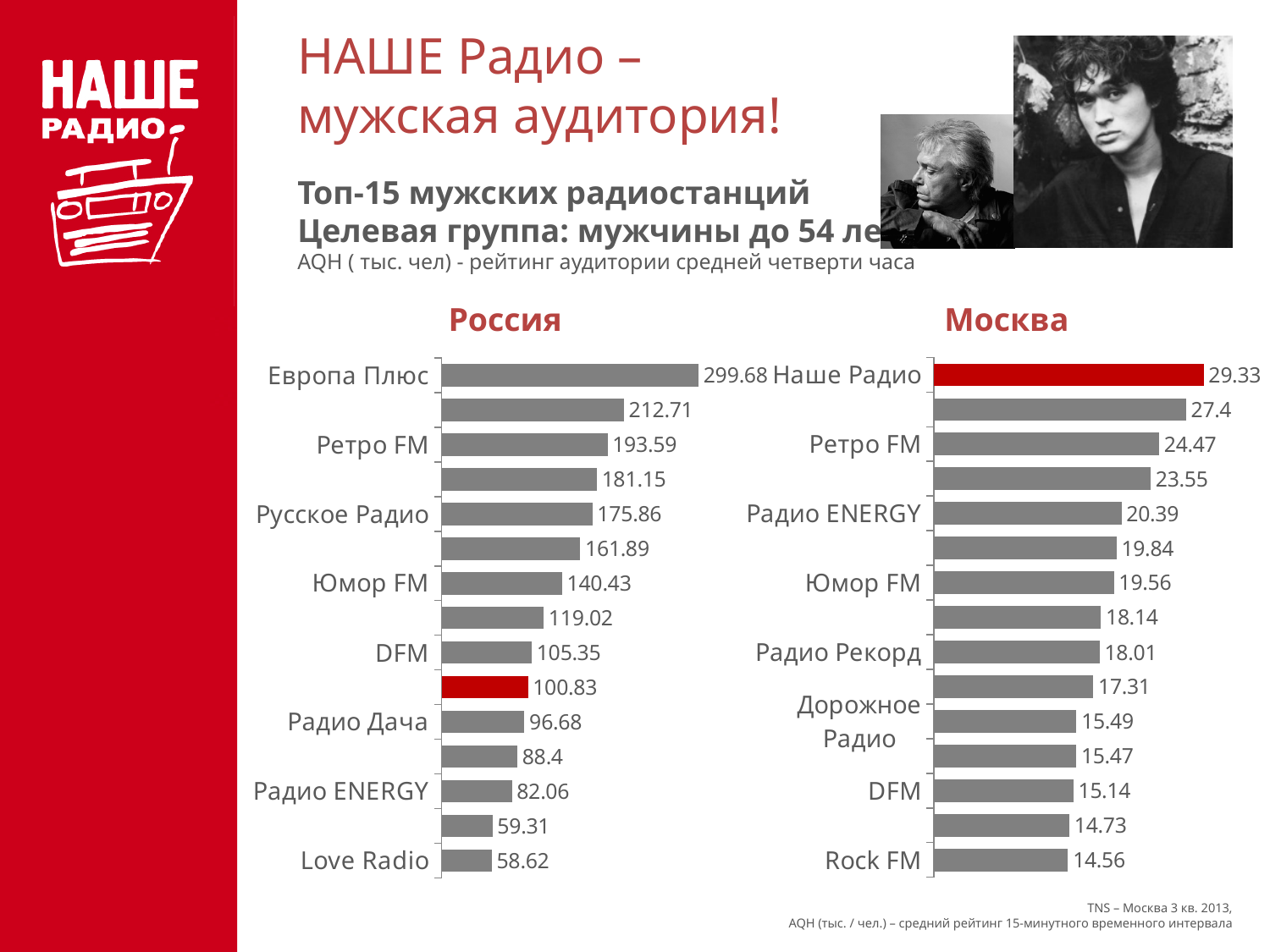
In the Москва chart, what is the difference between the values for Ретро FM and DFM? 9.33 In the Москва chart, what is the value for Наше Радио? 29.33 In the Россия chart, what is the value for Русское Радио? 175.86 In the Москва chart, what is the value for Радио Рекорд? 18.01 In the Россия chart, what value is shown next to the red bar? 100.83 In the Россия chart, which labelled station has the highest value? Европа Плюс In the Москва chart, which station has the lowest value? Rock FM In the Россия chart, what is the value for Европа Плюс? 299.68 How many bars does the Россия chart contain? 15 What type of chart is used for the Москва data? Bar chart In the Россия chart, what is the difference between the values for Ретро FM and Юмор FM? 53.16 In the Москва chart, which is larger: the value for Радио ENERGY or the value for Юмор FM? Радио ENERGY